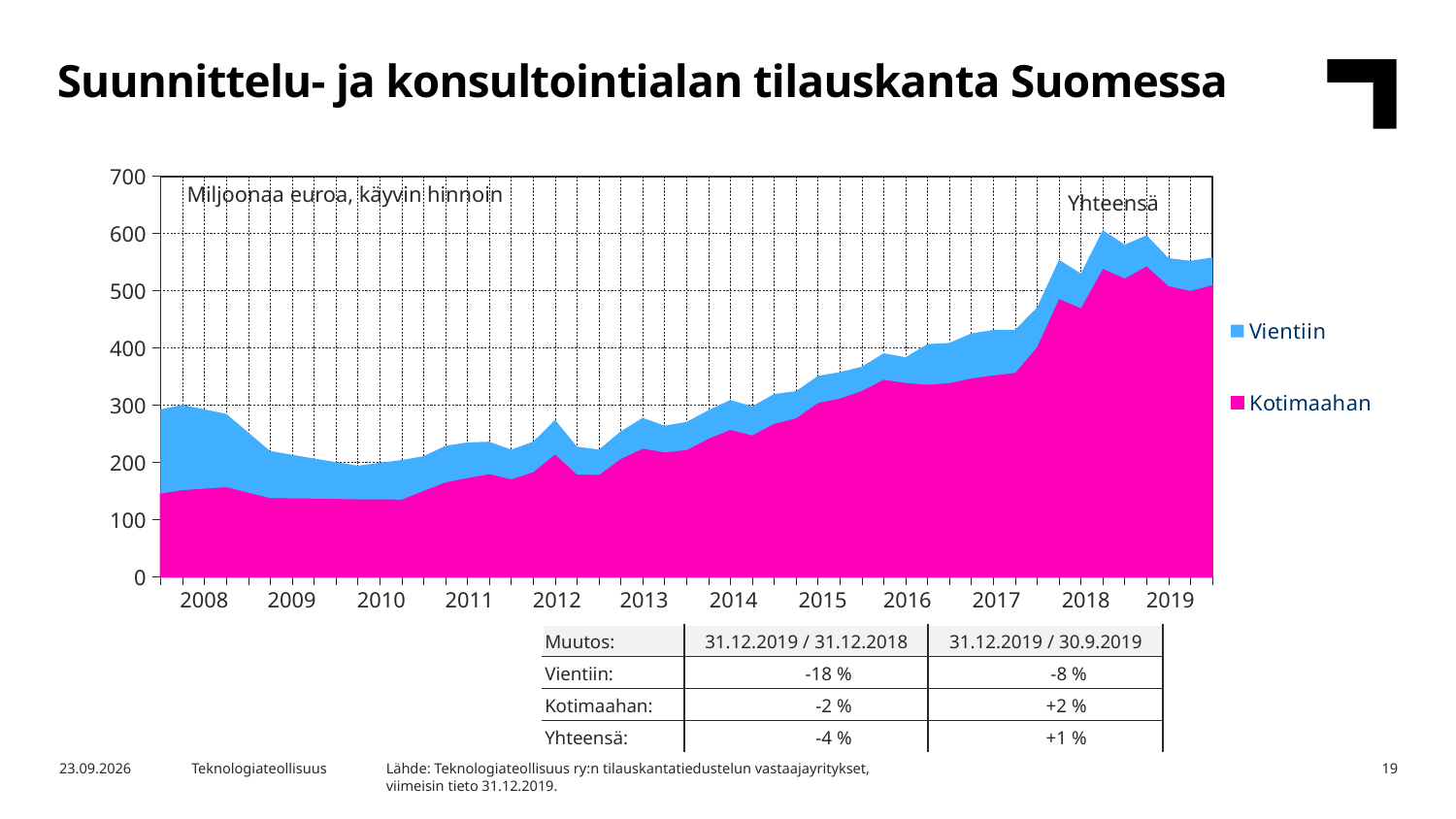
What are the two series named in the legend? Vientiin and Kotimaahan In which year does the total (Yhteensä) reach its highest level? 2018 What kind of chart is shown on the slide? Area chart Is the Kotimaahan value at the start of 2008 greater or less than 200? less How many years are labelled on the x axis? 12 How many series does the legend list? 2 Is the Kotimaahan value in 2012 greater or less than 300? less In 2019, which series is larger, Vientiin or Kotimaahan? Kotimaahan Does the Kotimaahan series overall rise or fall from 2008 to 2019? Rise What is the title of the slide's chart? Suunnittelu- ja konsultointialan tilauskanta Suomessa Is the total (Yhteensä) value at the end of 2019 greater or less than 500? greater